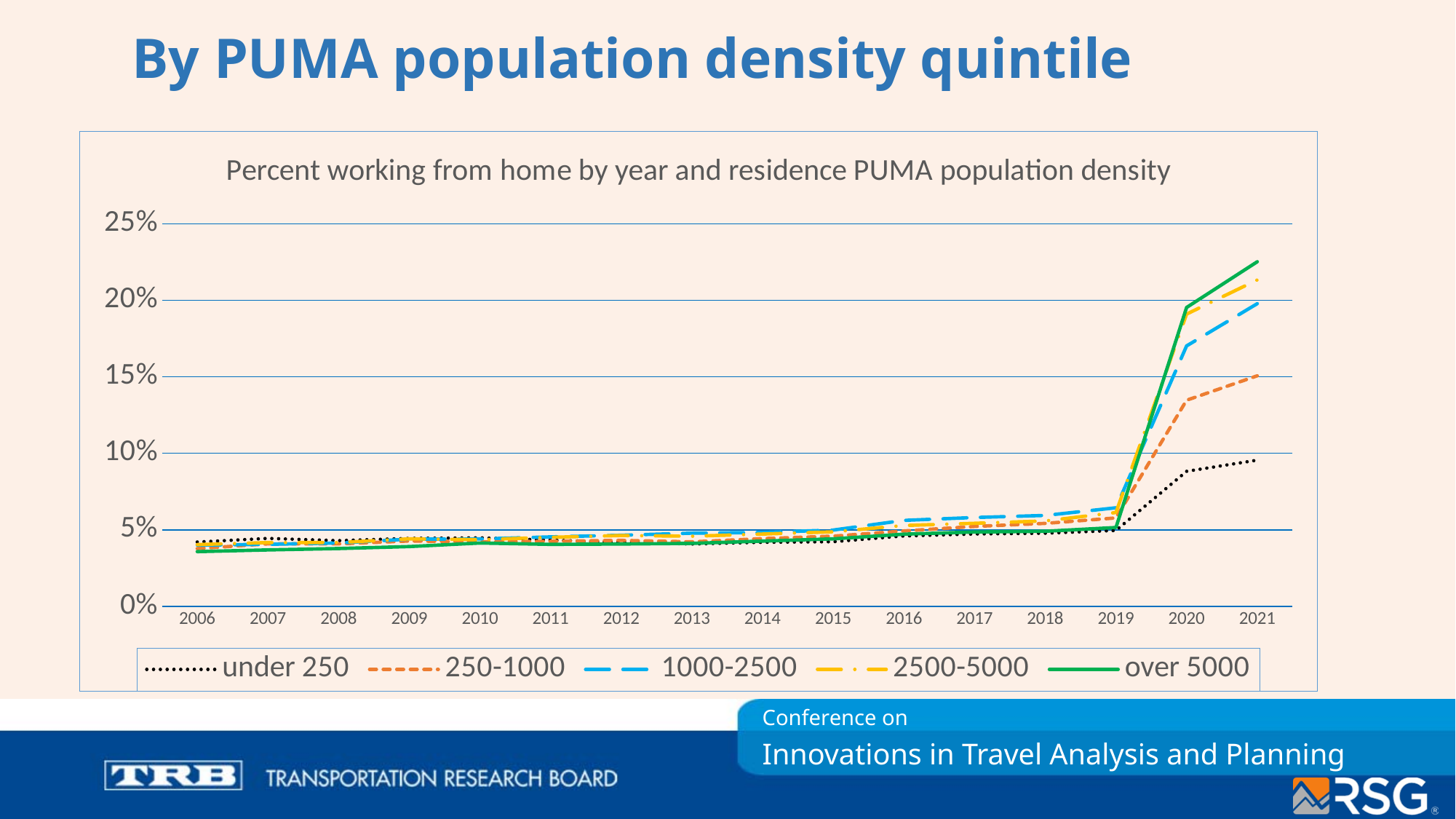
How many series does the legend list? 5 Does the under 250 series rise or fall from 2019 to 2021? Rise What kind of chart is shown on the slide? Line chart Is the value for the 250-1000 series in 2020 greater or less than 10%? greater In 2021, which is larger: the value for 250-1000 or the value for 1000-2500? 1000-2500 How many years are shown along the x axis? 16 Is the value for the over 5000 series in 2006 greater or less than 5%? less Is the value for the under 250 series in 2021 greater or less than 10%? less What is the title of the chart? Percent working from home by year and residence PUMA population density Which series has the lowest value in 2021? under 250 Which series has the highest value in 2021? over 5000